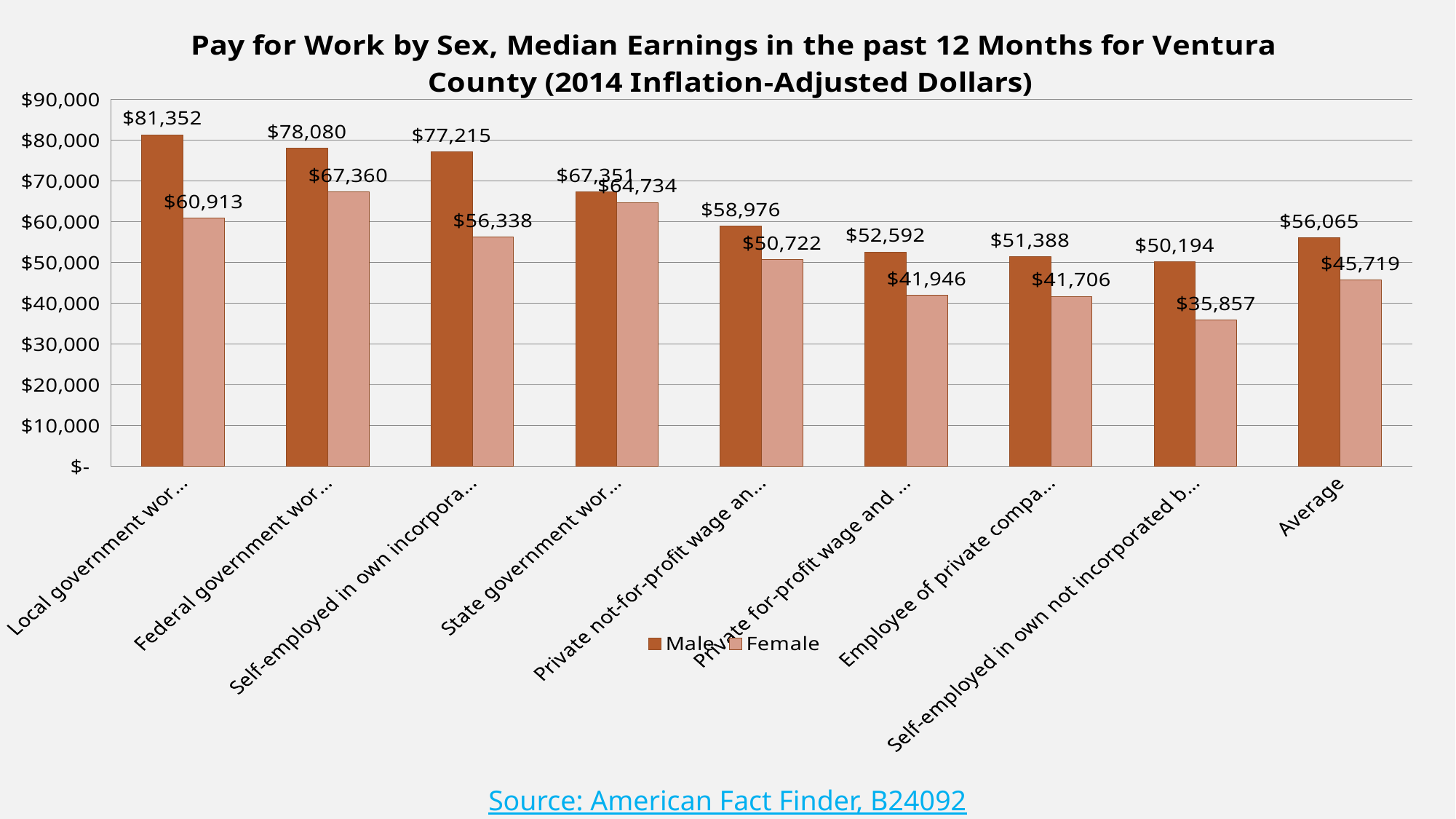
What is the difference between the Male and Female values for the Average category? $10,346 Which category has the lowest Female median earnings? Self-employed in own not incorporated How many categories are shown on the x axis? 9 What is the difference between the Male and Female values for the Local government category? $20,439 Is the Female value for the Self-employed in own not incorporated category greater or less than $40,000? less What is the Female value for the Federal government category? $67,360 What kind of chart is shown on the slide? bar chart What is the Female median earnings value for the Average category? $45,719 Which is larger: the Female value for Federal government or the Female value for State government? Federal government What is the Male median earnings value for the Average category? $56,065 How many series does the legend list? 2 Which category has the highest Male median earnings? Local government